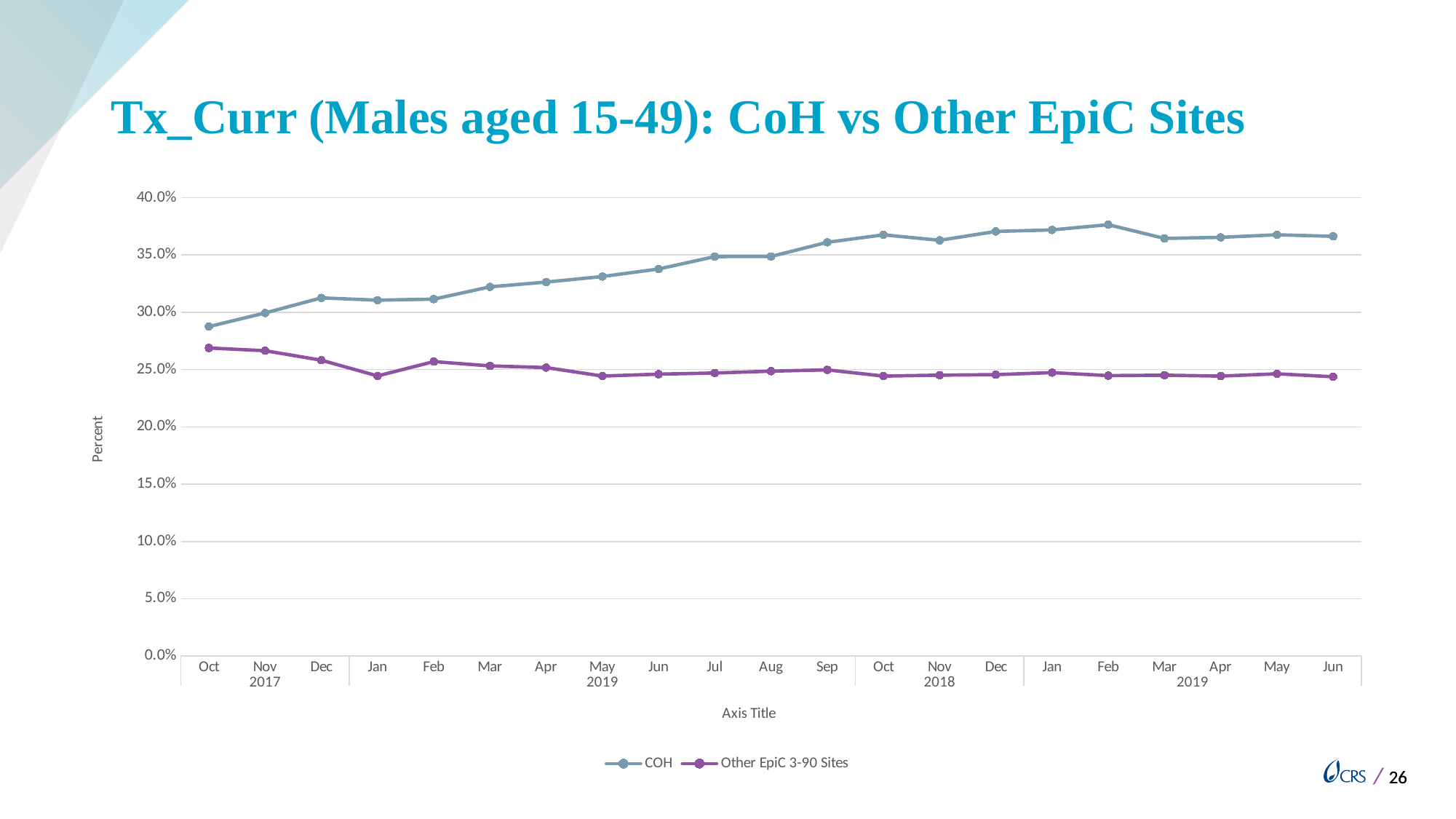
At which month does the COH series reach its lowest value? Oct 2017 Which series has the higher value at the first Oct (Oct 2017), COH or Other EpiC 3-90 Sites? COH Does the COH series generally rise or fall from Oct 2017 to Jun 2019? rise How many series does the legend list? 2 Is the Other EpiC 3-90 Sites value at the last point (Jun 2019) greater or less than 30.0%? less Is the COH value at the last point (Jun 2019) greater or less than 35.0%? greater What is the title of the vertical axis? Percent Which series has the higher value at the last point (Jun 2019), COH or Other EpiC 3-90 Sites? COH Does the Other EpiC 3-90 Sites series generally rise or fall from Oct 2017 to Jun 2019? fall Is the COH value at the first Oct (Oct 2017) greater or less than 30.0%? less How many monthly data points are plotted along the x axis for each series? 21 What kind of chart is shown on the slide? line chart